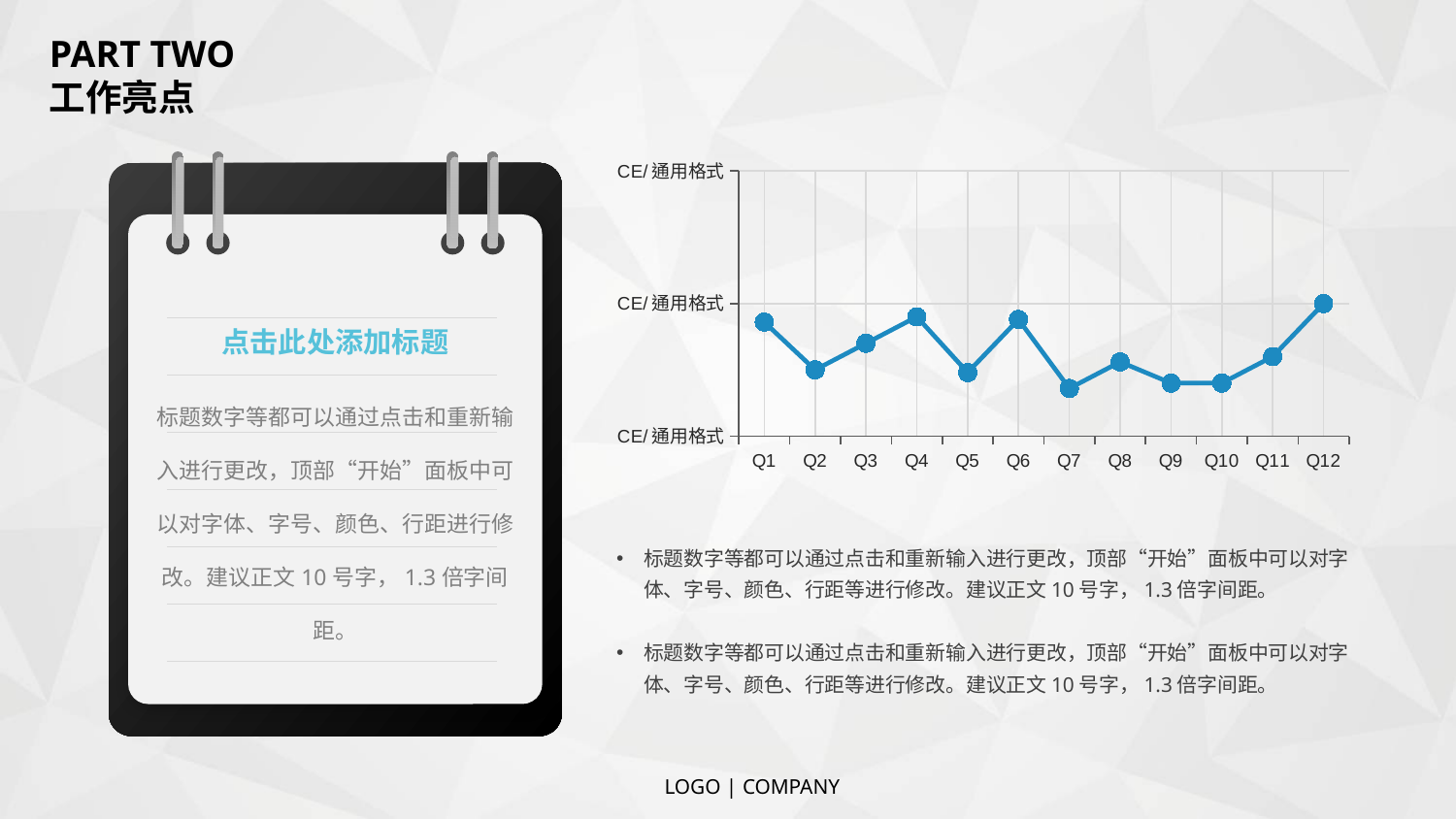
What is the label of the first category on the x axis of the line chart? Q1 What kind of chart is shown on the slide? line chart Do the values rise or fall from Q9 to Q12 on the line chart? rise Do the values rise or fall from Q1 to Q2 on the line chart? fall Which is larger on the line chart, the value for Q12 or the value for Q10? Q12 What colour is the line in the chart? blue Which quarter has the highest value on the line chart? Q12 How many data points are plotted on the line chart? 12 Which is larger on the line chart, the value for Q1 or the value for Q2? Q1 Which is larger on the line chart, the value for Q4 or the value for Q5? Q4